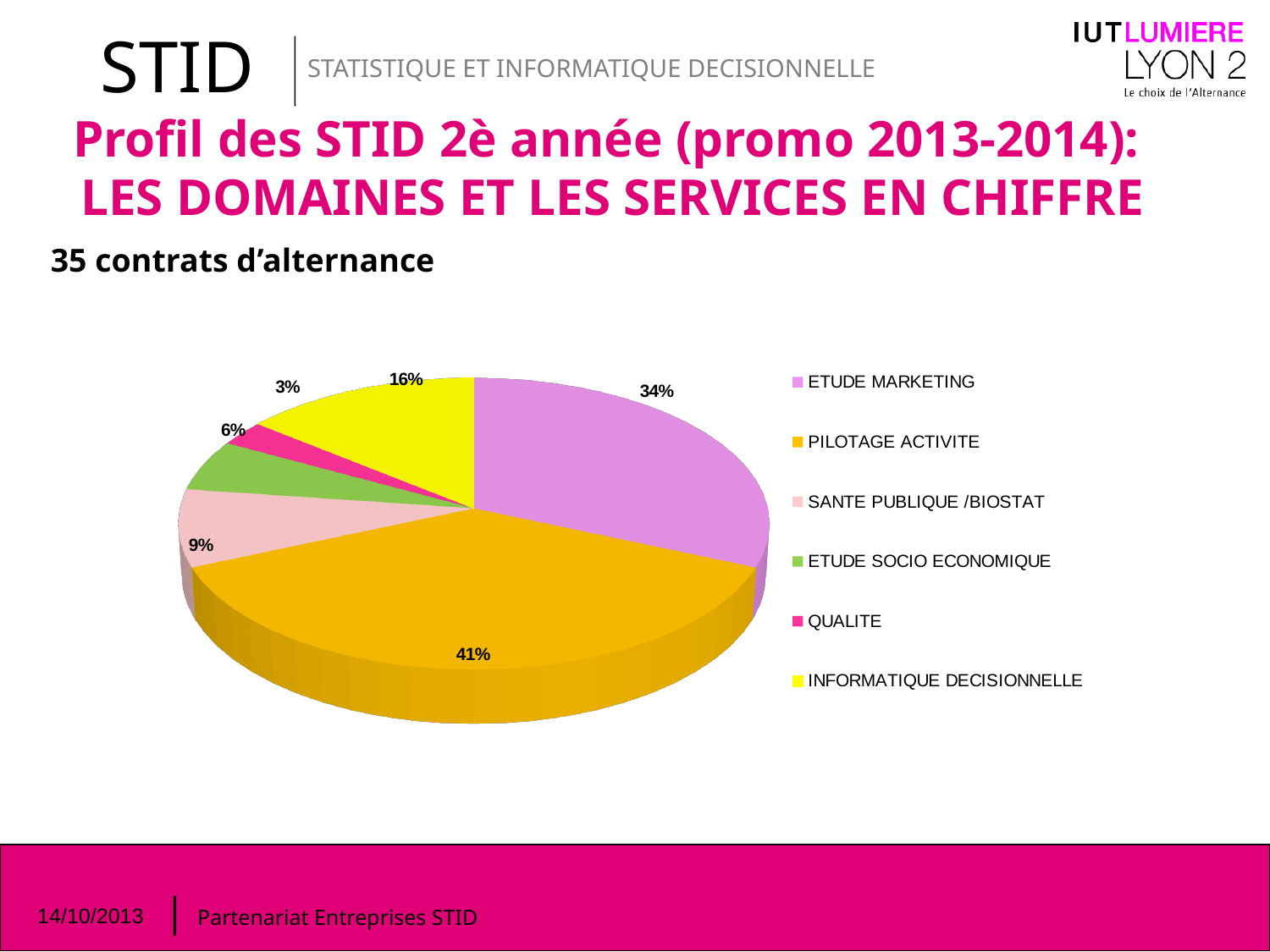
What is the difference in percentage points between PILOTAGE ACTIVITE and ETUDE MARKETING? 7 percentage points What colour is the slice for INFORMATIQUE DECISIONNELLE? yellow Which category has the smallest slice of the pie? QUALITE What share of the pie does QUALITE represent? 3% What kind of chart is shown on the slide? pie chart How many categories does the pie chart have? 6 What share of the pie does PILOTAGE ACTIVITE represent? 41% Which is larger, the share for ETUDE SOCIO ECONOMIQUE or the share for INFORMATIQUE DECISIONNELLE? INFORMATIQUE DECISIONNELLE What share of the pie does INFORMATIQUE DECISIONNELLE represent? 16% Which category has the largest slice of the pie? PILOTAGE ACTIVITE